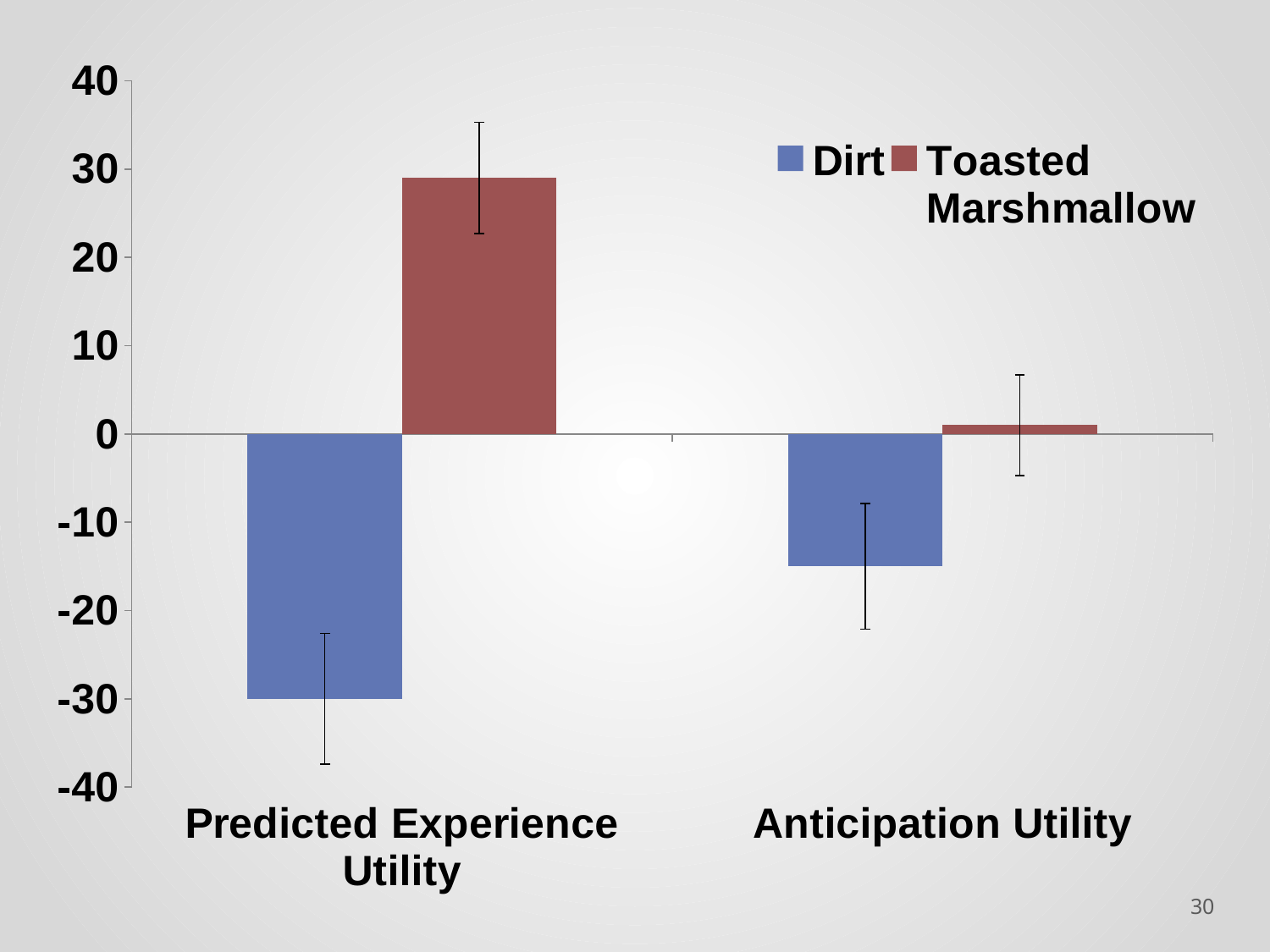
In Predicted Experience Utility, which series has the larger value, Dirt or Toasted Marshmallow? Toasted Marshmallow Is the value for Toasted Marshmallow in Predicted Experience Utility greater or less than 20? greater How many series does the legend list? 2 Which bar has the highest value on the chart? Toasted Marshmallow, Predicted Experience Utility Is the value for Dirt in Anticipation Utility greater or less than -10? less What is the value for Dirt in Predicted Experience Utility? -30 What are the two series named in the legend? Dirt and Toasted Marshmallow Which colour represents the Dirt series? blue Which bar has the lowest value on the chart? Dirt, Predicted Experience Utility Is the value for Toasted Marshmallow in Anticipation Utility greater or less than 10? less What kind of chart is shown on the slide? bar chart How many categories are shown on the x axis? 2